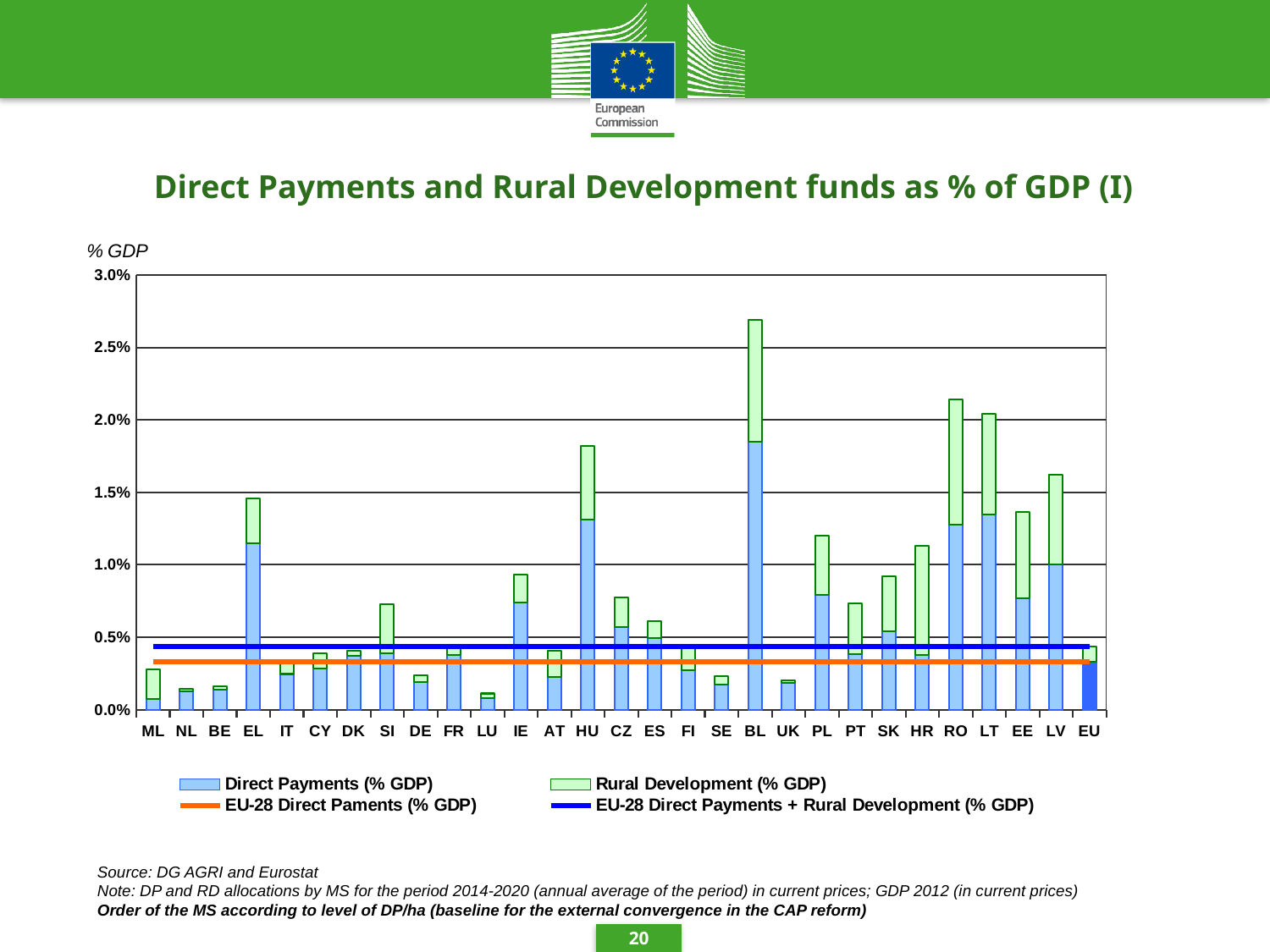
What colour is used for the Rural Development (% GDP) series? Light green Is the total bar for RO greater or less than 2.0%? greater How many member state/EU categories are shown along the x axis? 29 Which has the larger total bar, HU or PL? HU Which category has the lowest total bar? LU How many entries does the legend list? 4 Is the total bar for BL greater or less than 2.5%? greater Which category has the highest total bar (Direct Payments plus Rural Development as % of GDP)? BL Which has the larger total bar, LV or EE? LV Is the total bar for LU greater or less than 0.5%? less What kind of chart is shown on the slide? Stacked bar chart